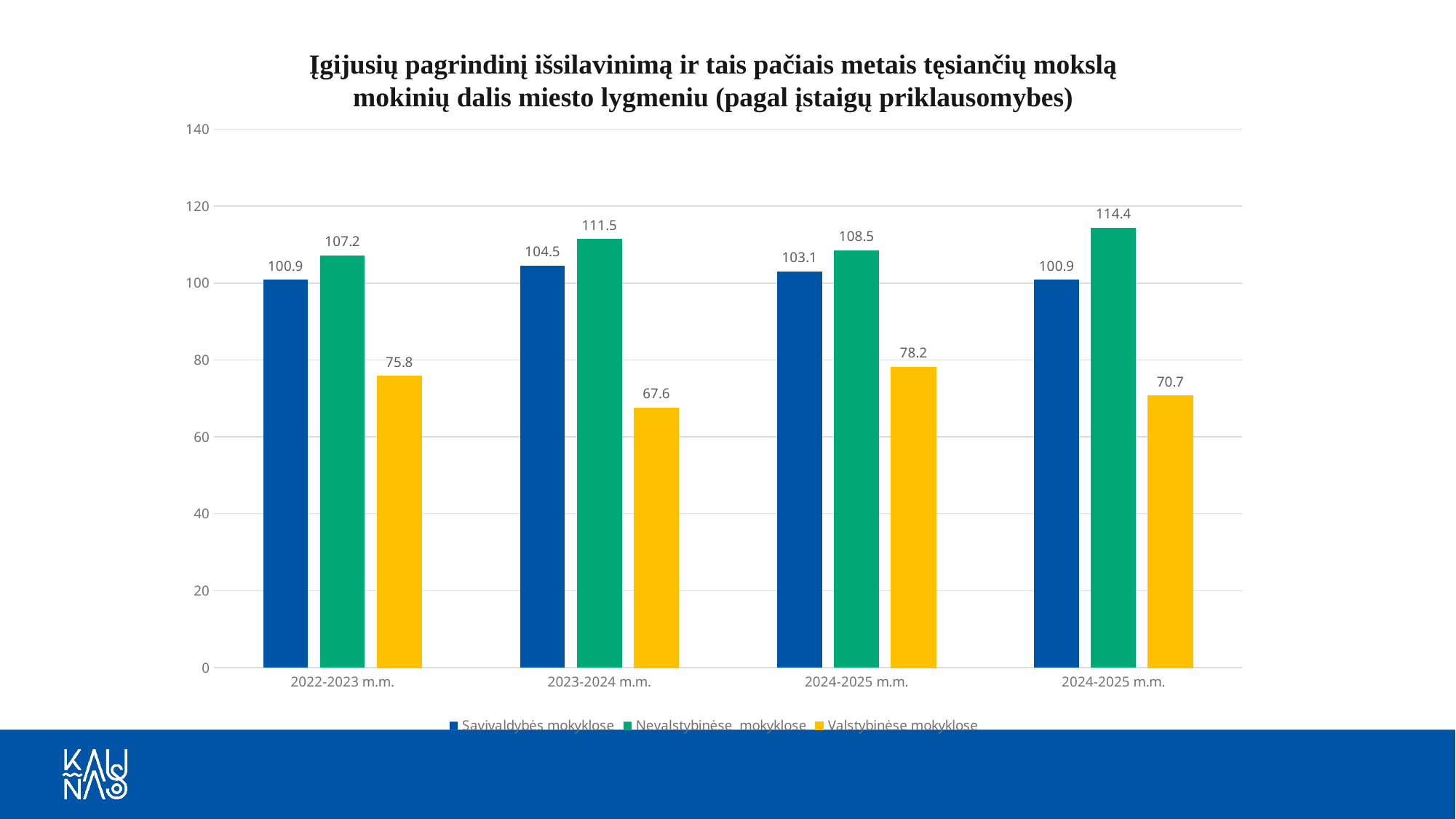
Is the value for Valstybinėse mokyklose in 2023-2024 m.m. greater or less than 80? less What kind of chart is shown on the slide? bar chart What is the value for Savivaldybės mokyklose in 2022-2023 m.m.? 100.9 How many category groups are shown on the x axis? 4 How many series does the legend list? 3 Which series has the lowest value in 2022-2023 m.m.? Valstybinėse mokyklose Which series has the highest value in 2023-2024 m.m.? Nevalstybinėse mokyklose What is the difference between Nevalstybinėse mokyklose and Savivaldybės mokyklose in 2023-2024 m.m.? 7.0 Which is larger in 2022-2023 m.m.: Savivaldybės mokyklose or Nevalstybinėse mokyklose? Nevalstybinėse mokyklose What is the value for Valstybinėse mokyklose in 2023-2024 m.m.? 67.6 What is the value for Valstybinėse mokyklose in 2022-2023 m.m.? 75.8 What is the value for Nevalstybinėse mokyklose in 2023-2024 m.m.? 111.5